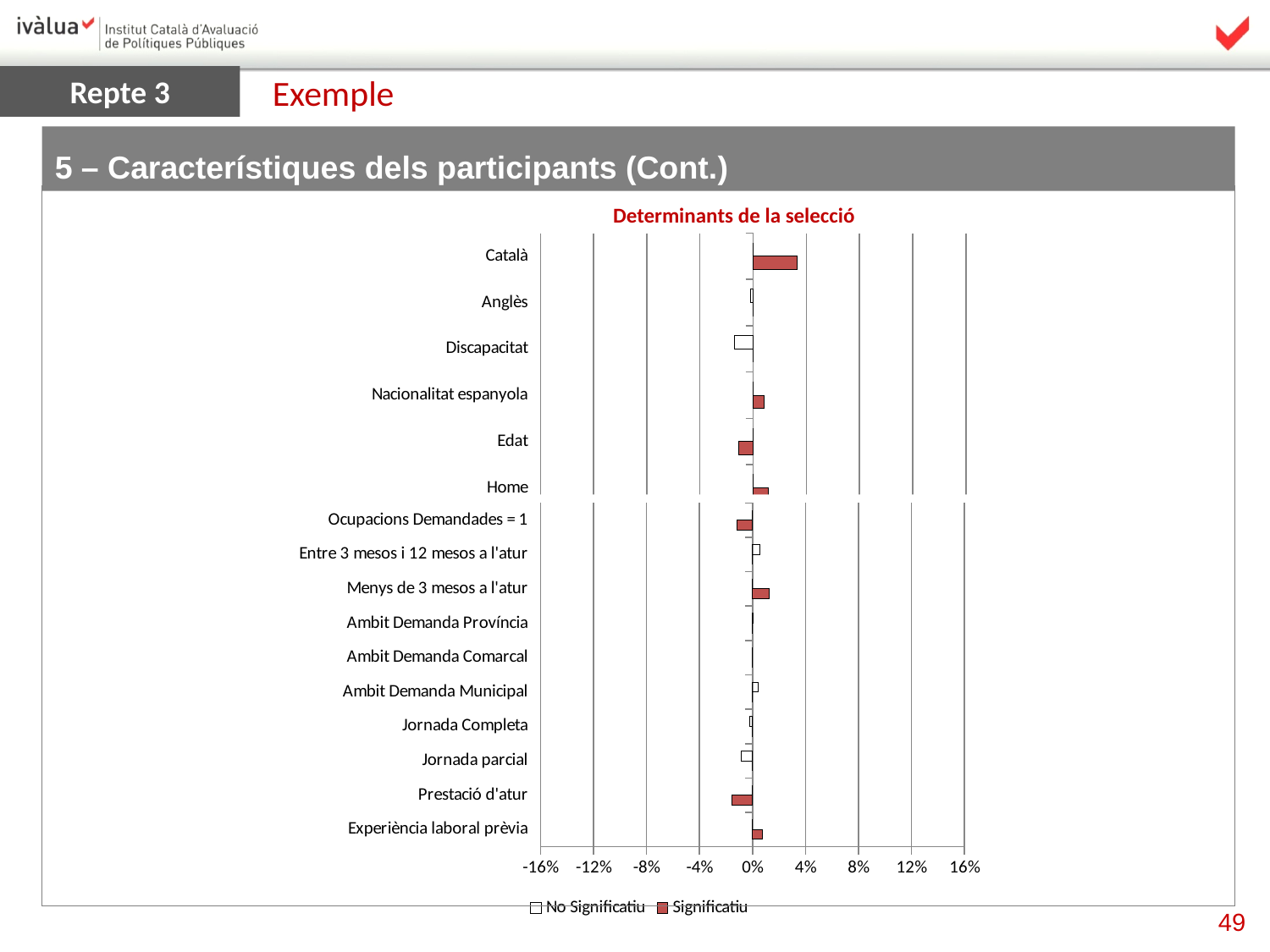
Is the value for Prestació d'atur greater or less than 0%? less Which is larger, the value for Català or the value for Nacionalitat espanyola? Català Is the value for Prestació d'atur greater or less than -4%? greater Is the value for Discapacitat greater or less than 0%? less How many series does the legend list? 2 What are the two series named in the legend? No Significatiu, Significatiu How many categories are plotted on the chart? 16 What kind of chart is shown on the slide? bar chart Which category has the highest (longest positive) value? Català What is the title of the chart? Determinants de la selecció